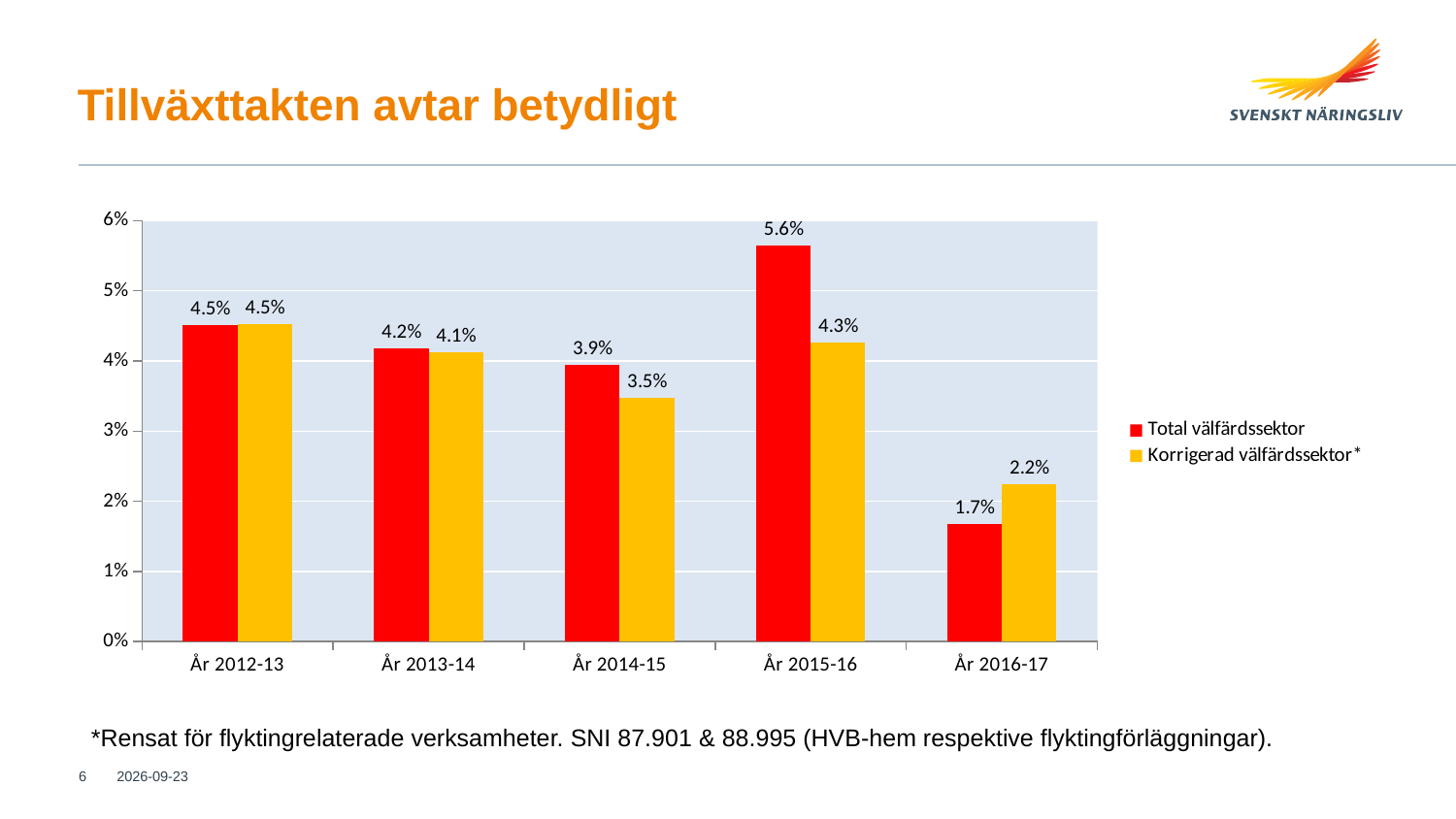
How many year categories are shown on the x axis? 5 What is the value for Total välfärdssektor in År 2015-16? 5.6% Is the value for Total välfärdssektor in År 2013-14 greater or less than 4%? greater What is the value for Total välfärdssektor in År 2016-17? 1.7% What is the value for Korrigerad välfärdssektor* in År 2014-15? 3.5% Which year has the highest value for Total välfärdssektor? År 2015-16 In År 2016-17, which is larger: Total välfärdssektor or Korrigerad välfärdssektor*? Korrigerad välfärdssektor* Which year has the lowest value for Korrigerad välfärdssektor*? År 2016-17 How many series does the legend list? 2 What colour are the bars for Total välfärdssektor? Red What kind of chart is shown on the slide? Bar chart What is the difference between Total välfärdssektor and Korrigerad välfärdssektor* in År 2015-16? 1.3%